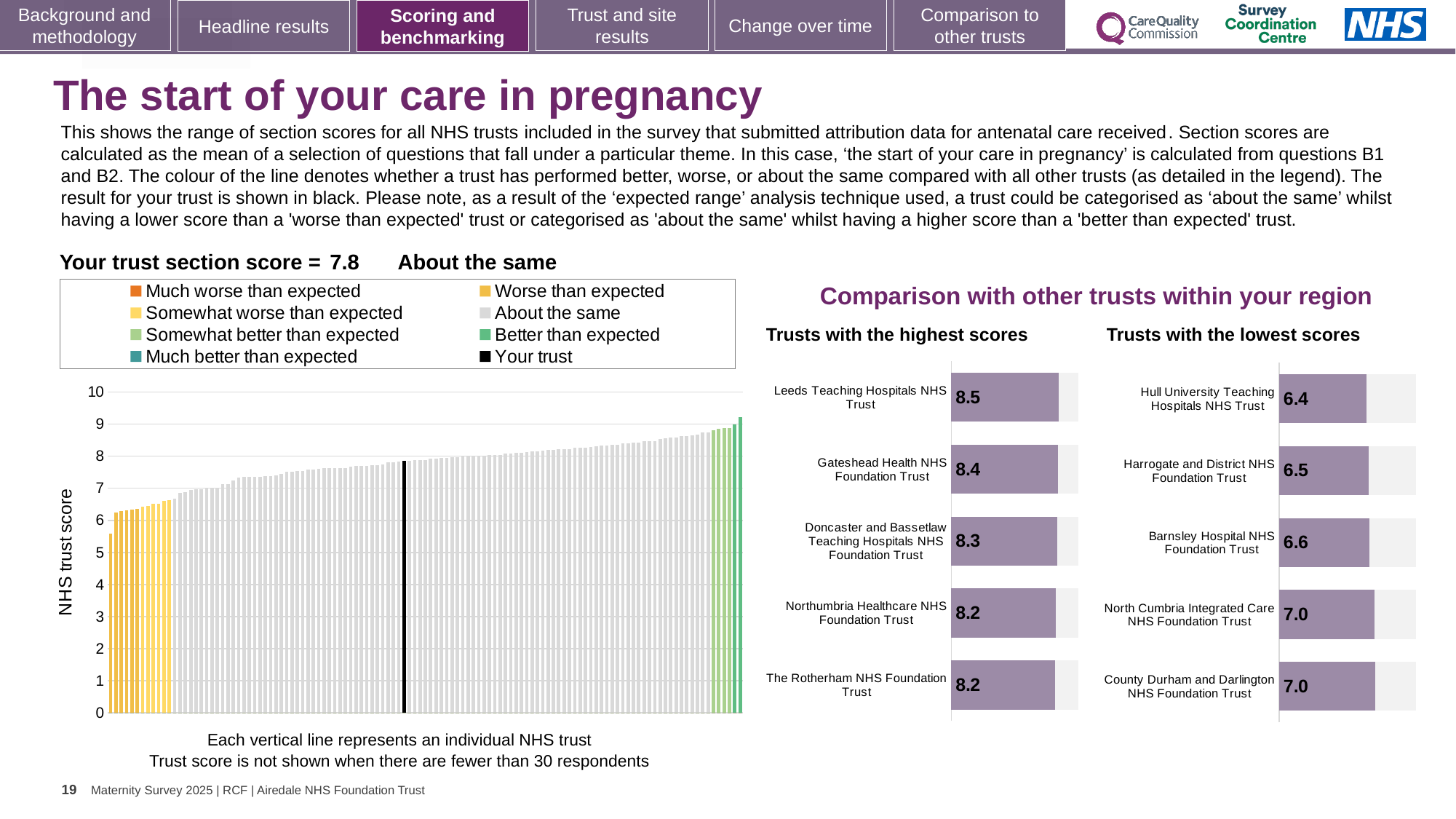
In the 'Trusts with the highest scores' chart, which has the higher score: Doncaster and Bassetlaw Teaching Hospitals NHS Foundation Trust or Northumbria Healthcare NHS Foundation Trust? Doncaster and Bassetlaw Teaching Hospitals NHS Foundation Trust What kind of chart is the 'NHS trust score' chart on the left of the slide? Bar chart In the 'Trusts with the lowest scores' chart, what is the score for County Durham and Darlington NHS Foundation Trust? 7.0 In the 'Trusts with the highest scores' chart, which trust has the highest score? Leeds Teaching Hospitals NHS Trust What is the section score for your trust shown above the 'NHS trust score' chart? 7.8 In the 'Trusts with the highest scores' chart, what is the score for Leeds Teaching Hospitals NHS Trust? 8.5 In the 'Trusts with the lowest scores' chart, what is the difference between the scores of Barnsley Hospital NHS Foundation Trust and Hull University Teaching Hospitals NHS Trust? 0.2 In the 'Trusts with the highest scores' chart, what is the difference between the scores of Leeds Teaching Hospitals NHS Trust and Gateshead Health NHS Foundation Trust? 0.1 In the 'Trusts with the lowest scores' chart, what is the score for Hull University Teaching Hospitals NHS Trust? 6.4 In the 'Trusts with the lowest scores' chart, which trust has the lowest score? Hull University Teaching Hospitals NHS Trust How many trusts are shown in the 'Trusts with the highest scores' chart? 5 In the 'NHS trust score' chart on the left, do the values rise or fall from left to right? Rise